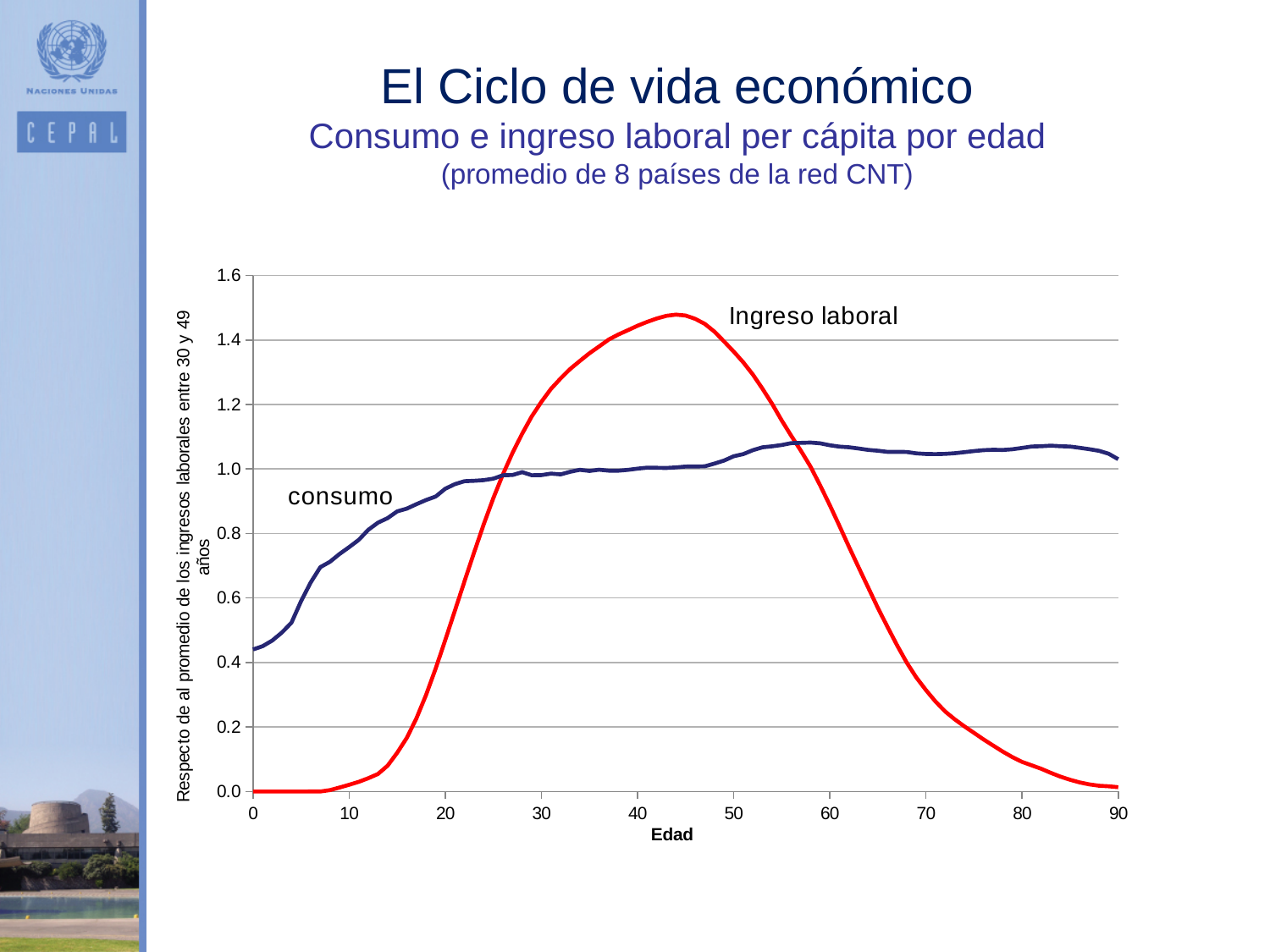
How many series are plotted on the chart? 2 What kind of chart is shown on the slide? line chart Is the value of Ingreso laboral at age 10 greater or less than 0.2? less Is the value of Ingreso laboral at age 80 greater or less than 0.4? less Which series reaches the highest value on the chart? Ingreso laboral Is the value of Ingreso laboral at age 40 greater or less than 1.2? greater Does the consumo series rise or fall between age 0 and age 20? rise Does the Ingreso laboral series rise or fall between age 50 and age 90? fall At age 40, which series has the higher value, consumo or Ingreso laboral? Ingreso laboral What is the label of the x axis? Edad At age 70, which series has the higher value, consumo or Ingreso laboral? consumo